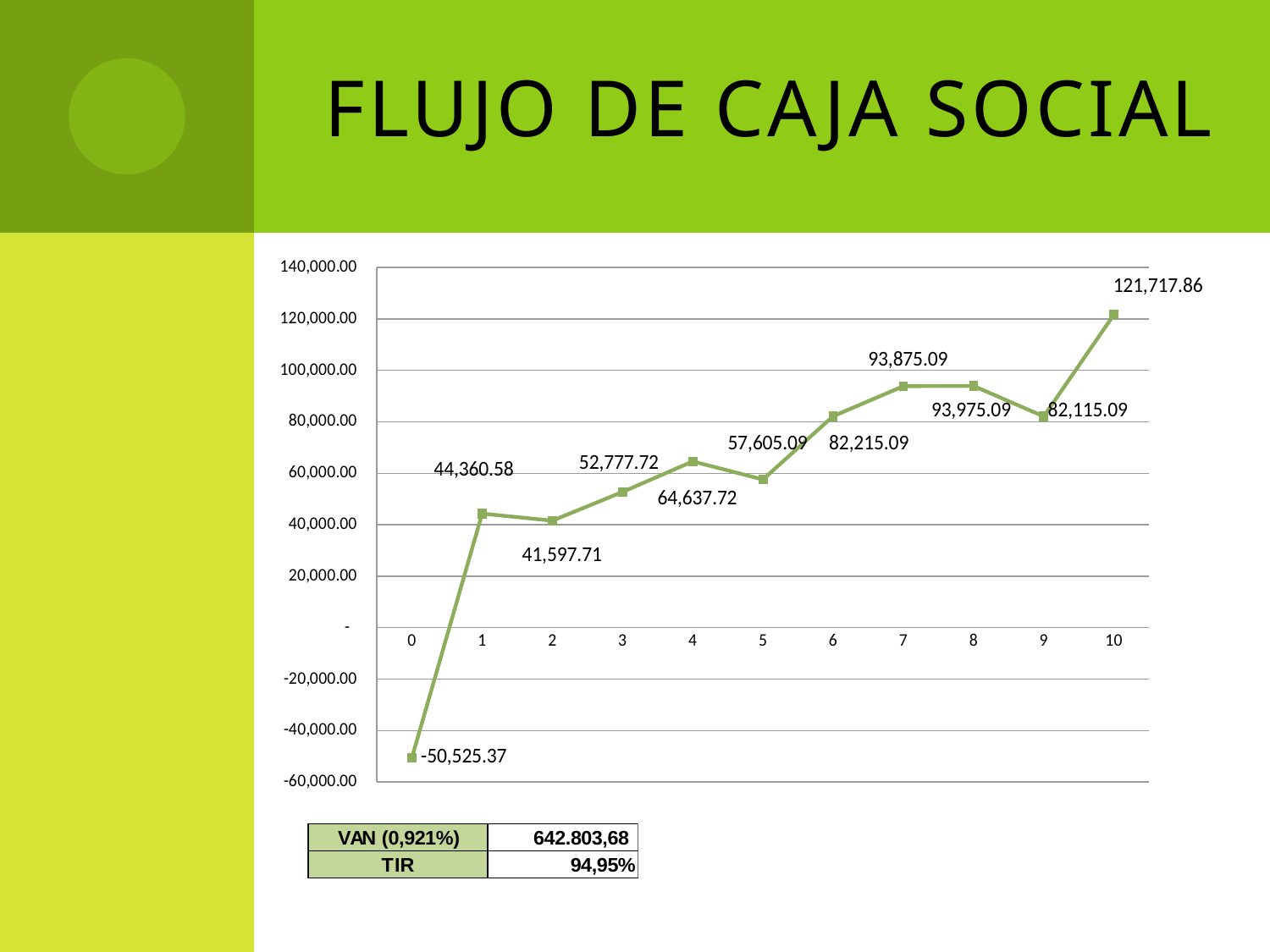
Is the value at x = 3 greater or less than 60,000.00? less Does the line rise or fall from x = 9 to x = 10? rise Which has the larger value, x = 5 or x = 6? 6 What is the difference between the values at x = 1 and x = 2? 2,762.87 What kind of chart is shown on the slide? line chart How many data points are plotted on the line? 11 What is the value plotted at x = 4? 64,637.72 What is the value plotted at x = 7? 93,875.09 At which x value is the plotted value lowest? 0 What is the value plotted at x = 10? 121,717.86 What is the value plotted at x = 0? -50,525.37 At which x value is the plotted value highest? 10